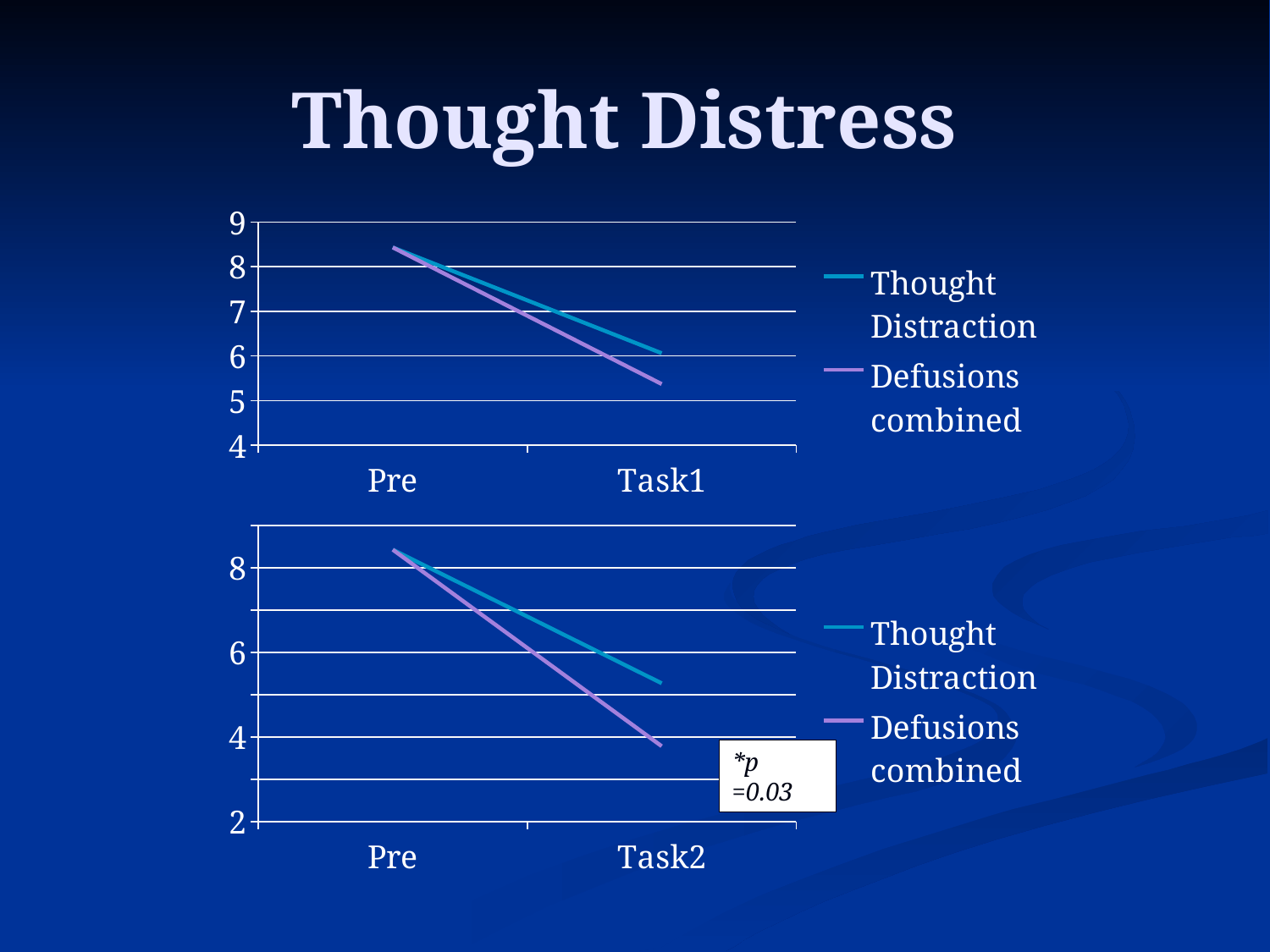
In the top chart, which series has the higher value at Task1, Thought Distraction or Defusions combined? Thought Distraction In the bottom chart, which series has the lower value at Task2, Thought Distraction or Defusions combined? Defusions combined How many categories are on the x axis of the bottom chart? 2 In the top chart, does the Thought Distraction line rise or fall from Pre to Task1? fall How many series does the legend of the top chart list? 2 What p value is shown in the text box on the bottom chart? *p =0.03 What is the title of the slide? Thought Distress What kind of chart is the top chart on the slide? line chart In the bottom chart, is the value for Defusions combined at Task2 greater or less than 4? less In the bottom chart, is the value for Thought Distraction at Pre greater or less than 8? greater In the top chart, is the value for Defusions combined at Task1 greater or less than 6? less In the bottom chart, does the Defusions combined line rise or fall from Pre to Task2? fall